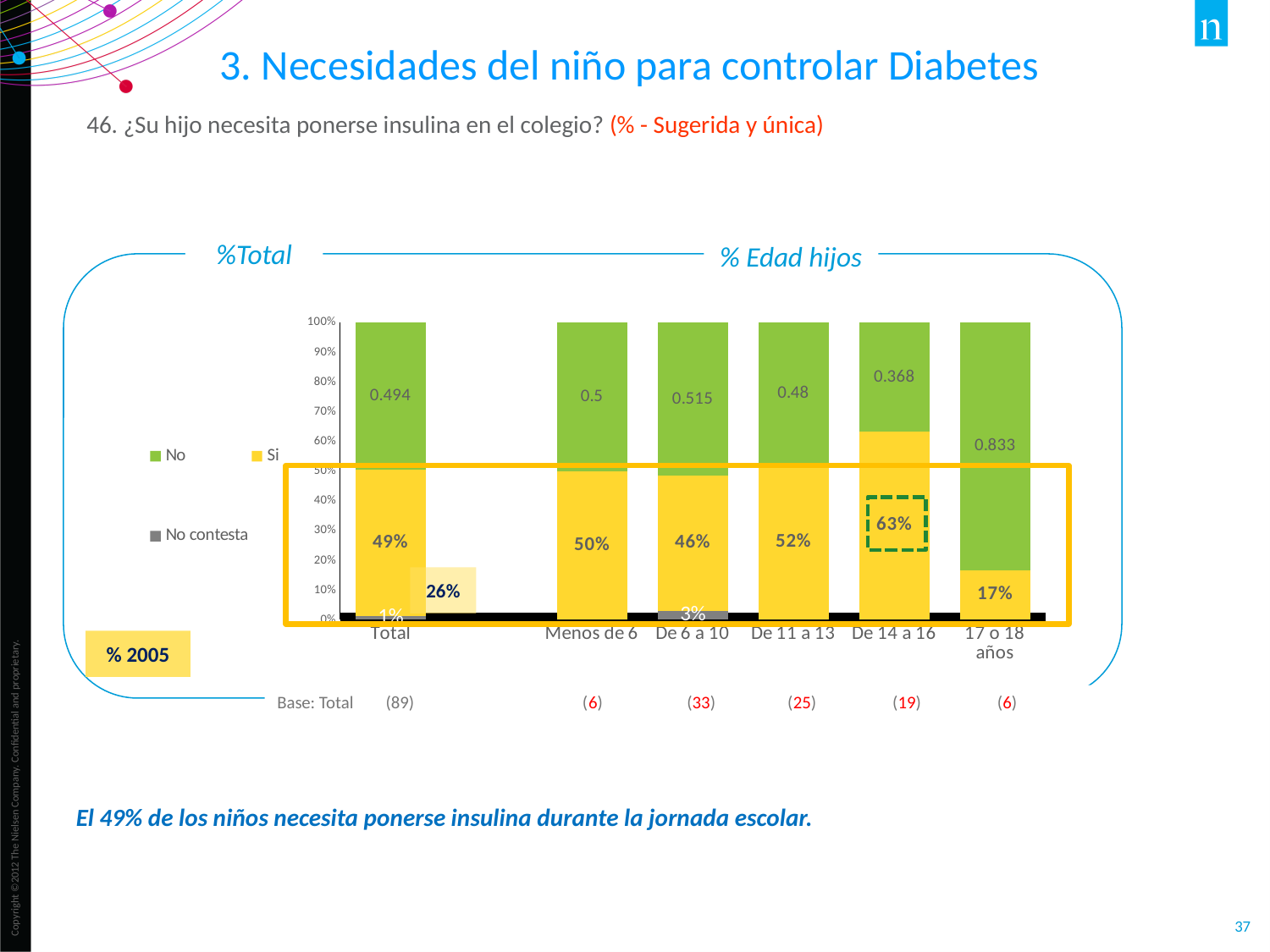
What is the difference between the 'Si' values for 'De 14 a 16' and '17 o 18 años'? 46% Which category has the lowest 'Si' value? 17 o 18 años How many categories are shown along the x axis of the chart? 6 Which is larger, the 'Si' value for 'De 11 a 13' or for 'De 6 a 10'? De 11 a 13 What is the 'Si' value for the 'De 14 a 16' category? 63% What kind of chart is shown on the slide? stacked bar chart What is the 'No' value labelled for the 'De 6 a 10' category? 0.515 What is the 'Si' value for the 'Total' category? 49% What is the 'No' value labelled for the '17 o 18 años' category? 0.833 Which category has the highest 'Si' value? De 14 a 16 What is the 'No contesta' value for the 'De 6 a 10' category? 3% How many series does the chart legend list? 3